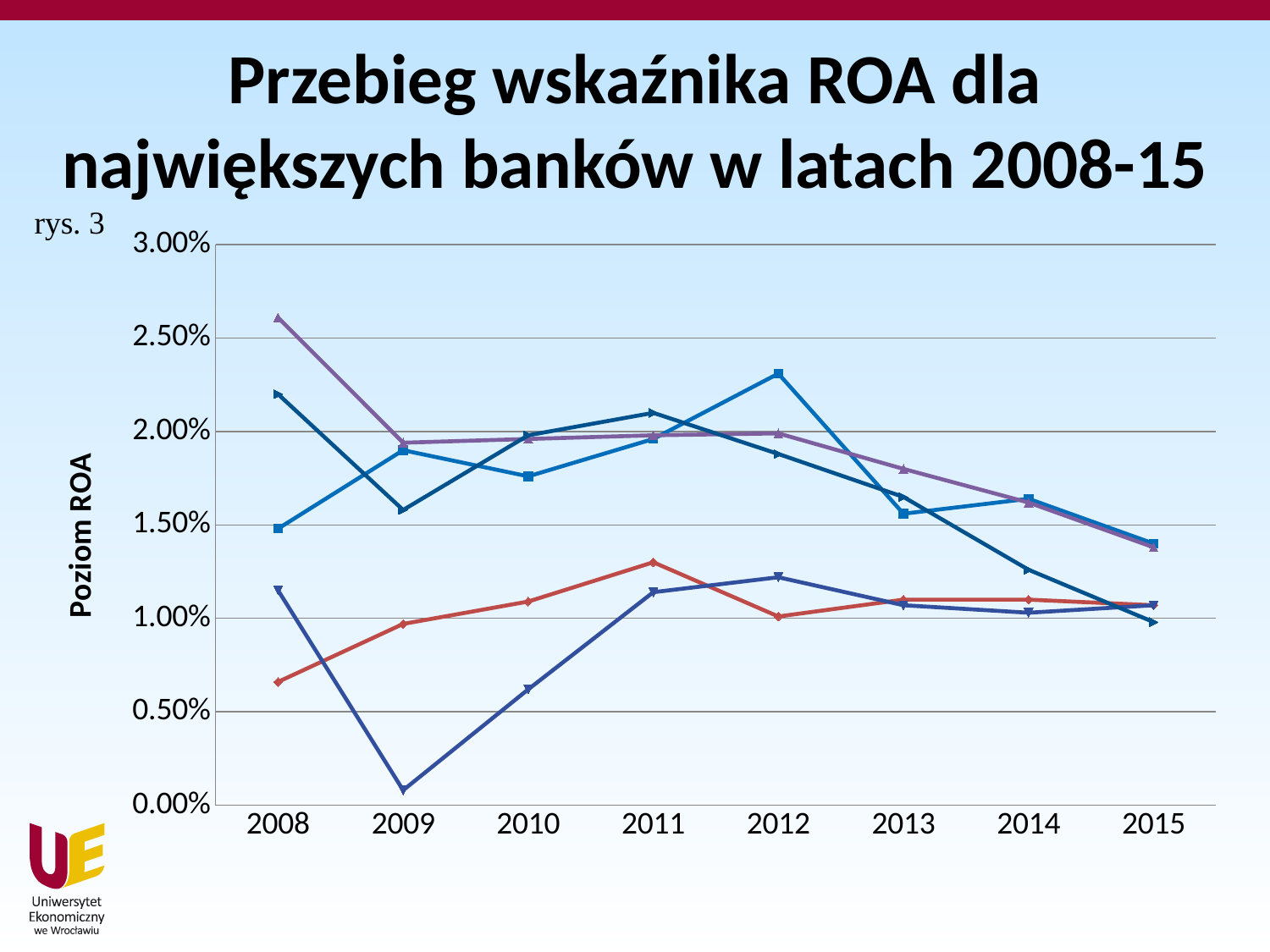
Is the value of the purple line in 2013 greater or less than 1.50%? greater How many lines are plotted on the chart? 5 Does the purple line rise or fall between 2012 and 2015? fall How many years are shown on the x axis of the chart? 8 Is the value of the light blue line in 2012 greater or less than 2.00%? greater In which year does the lowest point of any line on the chart occur? 2009 What is the highest value shown on the vertical axis? 3.00% What is the label of the vertical axis? Poziom ROA Is the value of the purple line in 2008 greater or less than 2.00%? greater What kind of chart is shown on the slide? line chart In which year does the highest point of any line on the chart occur? 2008